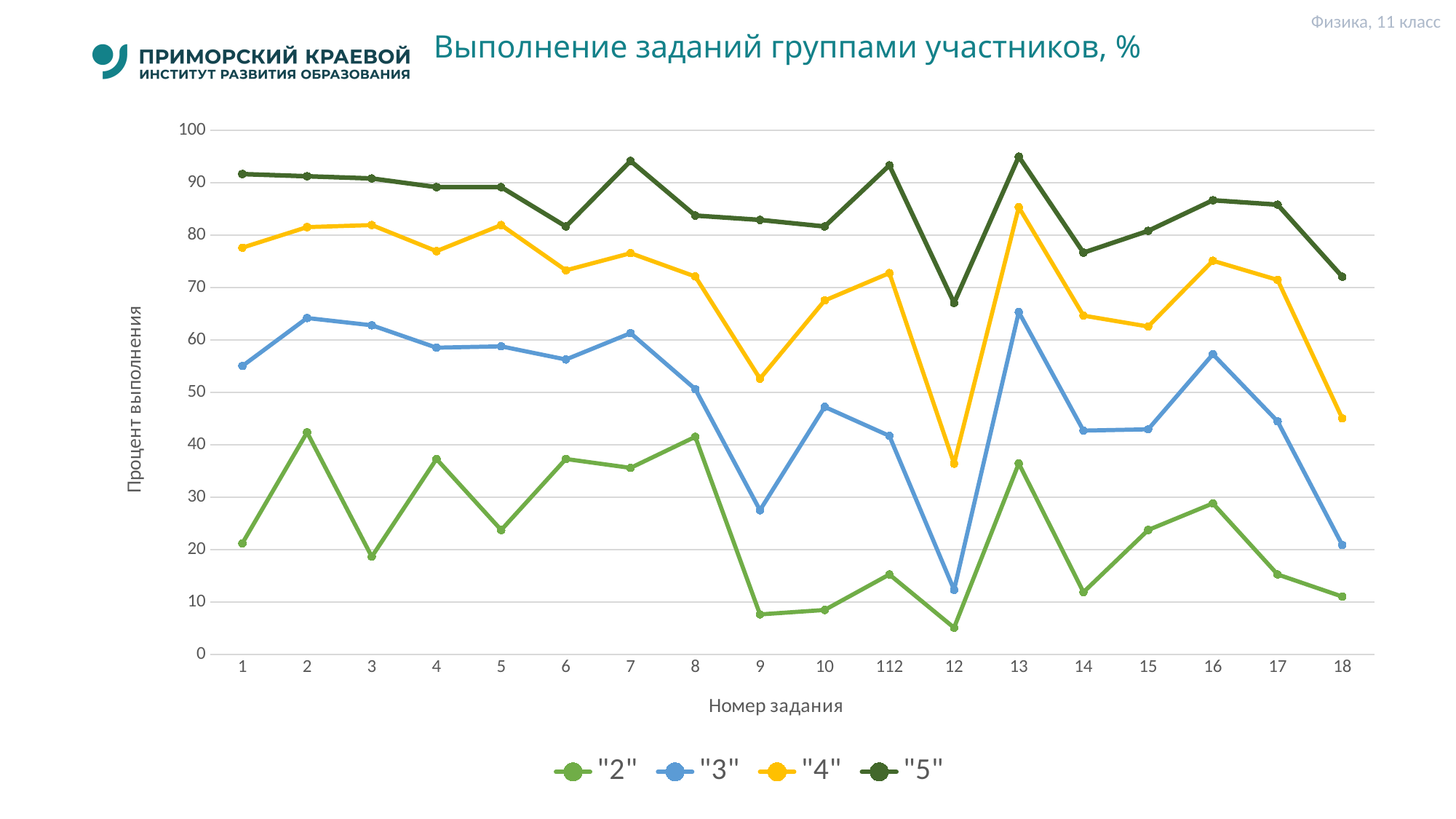
What kind of chart is shown on the slide? line chart Which is larger: series "4" at task 13 or series "5" at task 14? series "4" at task 13 Is the value for series "5" at task 1 greater or less than 90? greater What is the title of the x axis? Номер задания Is the value for series "4" at task 18 greater or less than 50? less For series "4", which task number has the highest value? 13 How many task numbers are plotted along the x axis? 18 For series "5", which task number has the lowest value? 12 How many series does the legend list? 4 Is the value for series "3" at task 9 greater or less than 30? less For series "2", which task number has the lowest value? 12 Do the values for series "5" rise or fall from task 1 to task 5? fall